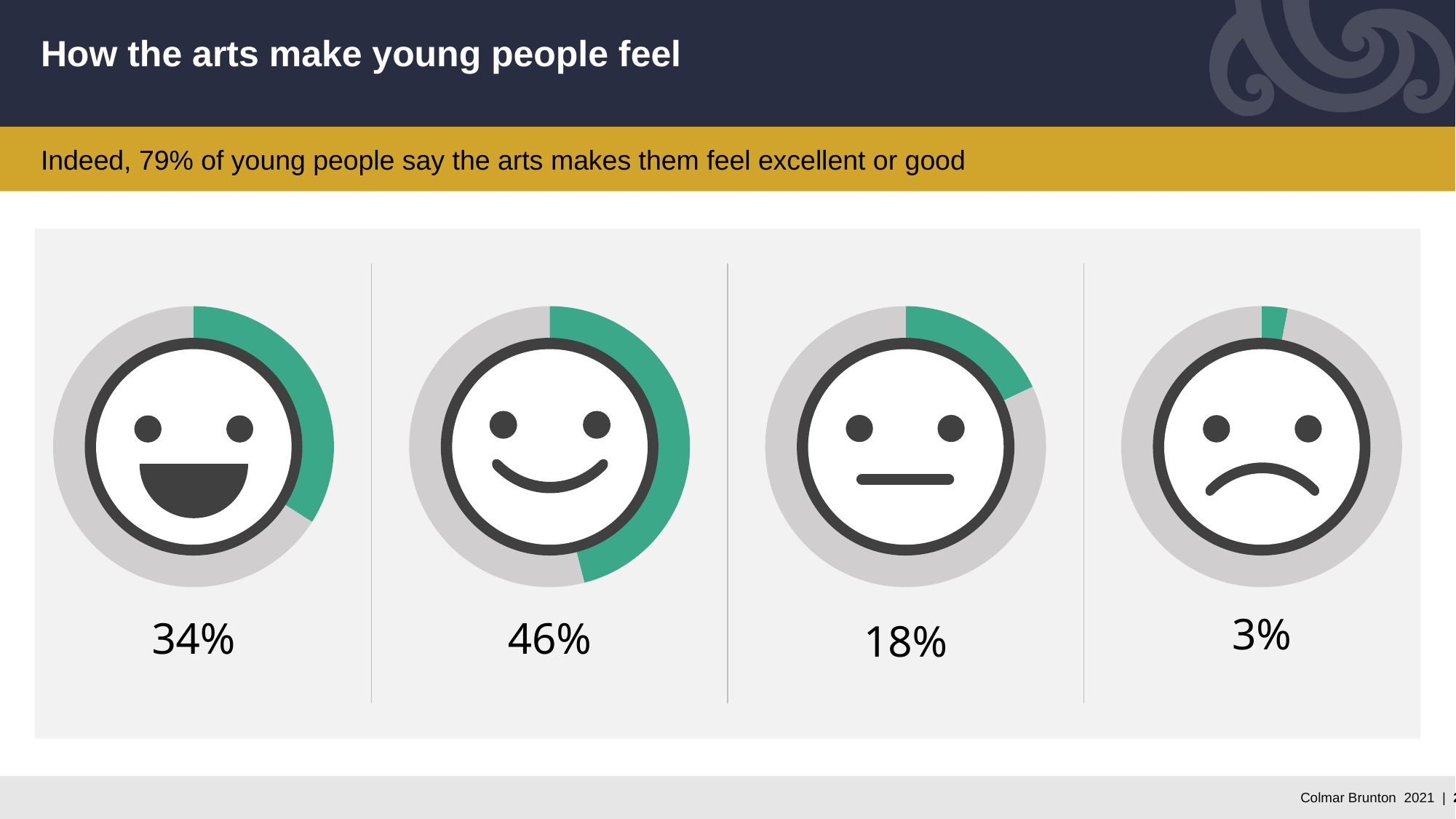
What value is shown below the rightmost ring chart (the frowning face)? 3% Which is larger: the value for the leftmost ring chart or the value for the third ring chart from the left? The leftmost (34%) Which of the four ring charts shows the lowest percentage? The rightmost (frowning face), 3% How many ring charts are shown on the slide? 4 What value is shown below the leftmost ring chart (the face with the wide grin)? 34% What is the difference between the value of the second ring chart (46%) and the leftmost ring chart (34%)? 12 percentage points What value is shown below the second ring chart from the left (the smiling face)? 46% What kind of chart is used to display each percentage on the slide? Ring (donut) chart What value is shown below the third ring chart from the left (the neutral face)? 18% Which of the four ring charts shows the highest percentage? The second from the left (smiling face), 46% According to the yellow banner, what percentage of young people say the arts make them feel excellent or good? 79% What is the difference between the value of the third ring chart (18%) and the rightmost ring chart (3%)? 15 percentage points